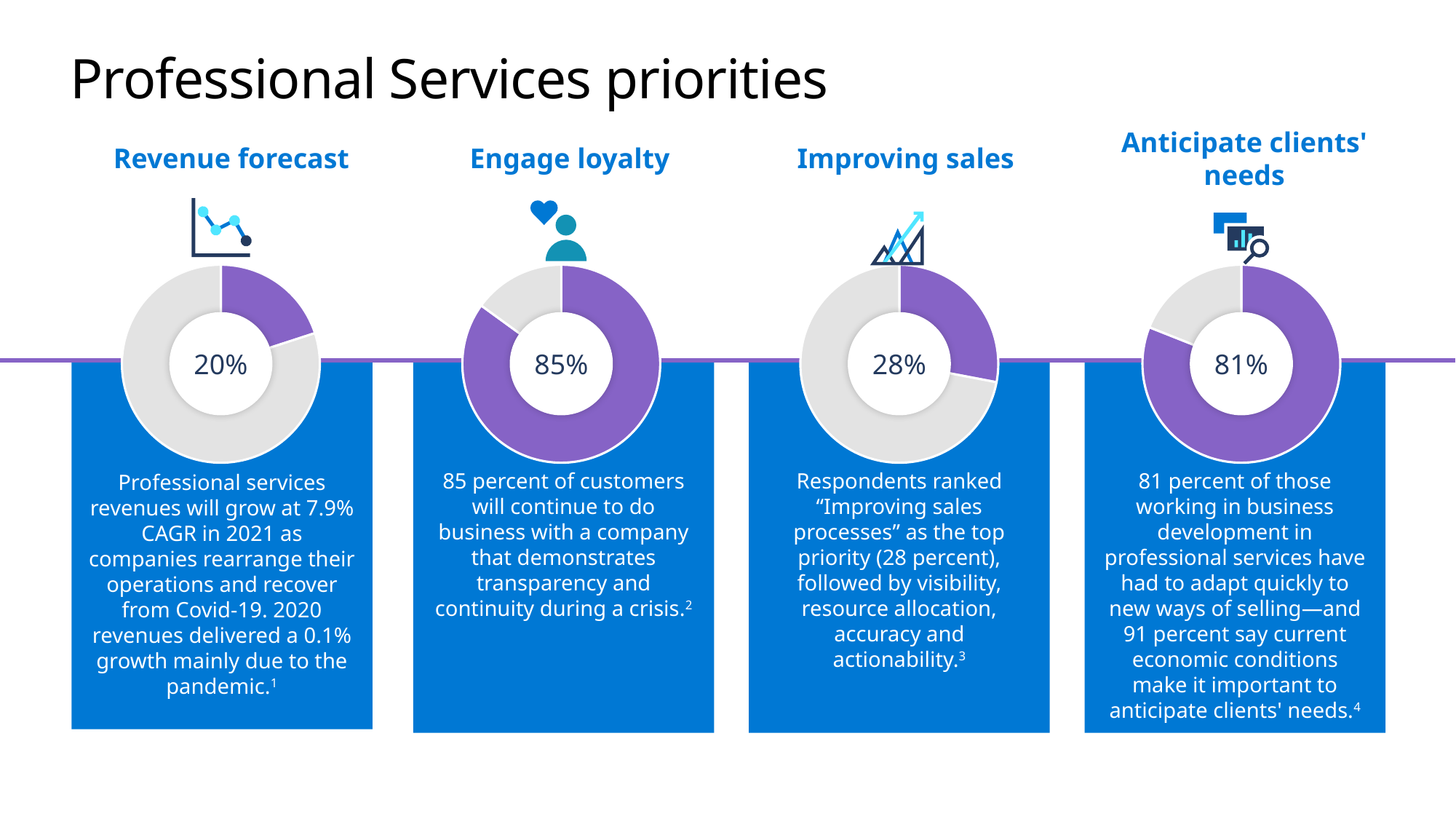
How many donut charts are on the slide? 4 Which of the four donut charts shows the lowest percentage? Revenue forecast What value is shown in the centre of the Engage loyalty donut chart? 85% What value is shown in the centre of the Anticipate clients' needs donut chart? 81% What is the difference between the percentage in the Improving sales chart and the percentage in the Revenue forecast chart? 8% What value is shown in the centre of the Improving sales donut chart? 28% What colour is the filled (highlighted) portion of each donut chart? Purple What is the difference between the percentage in the Engage loyalty chart and the percentage in the Anticipate clients' needs chart? 4% Which of the four donut charts shows the highest percentage? Engage loyalty What value is shown in the centre of the Revenue forecast donut chart? 20% Which is larger, the percentage in the Improving sales chart or the percentage in the Revenue forecast chart? Improving sales What kind of chart is used for each of the four priorities on the slide? Donut chart